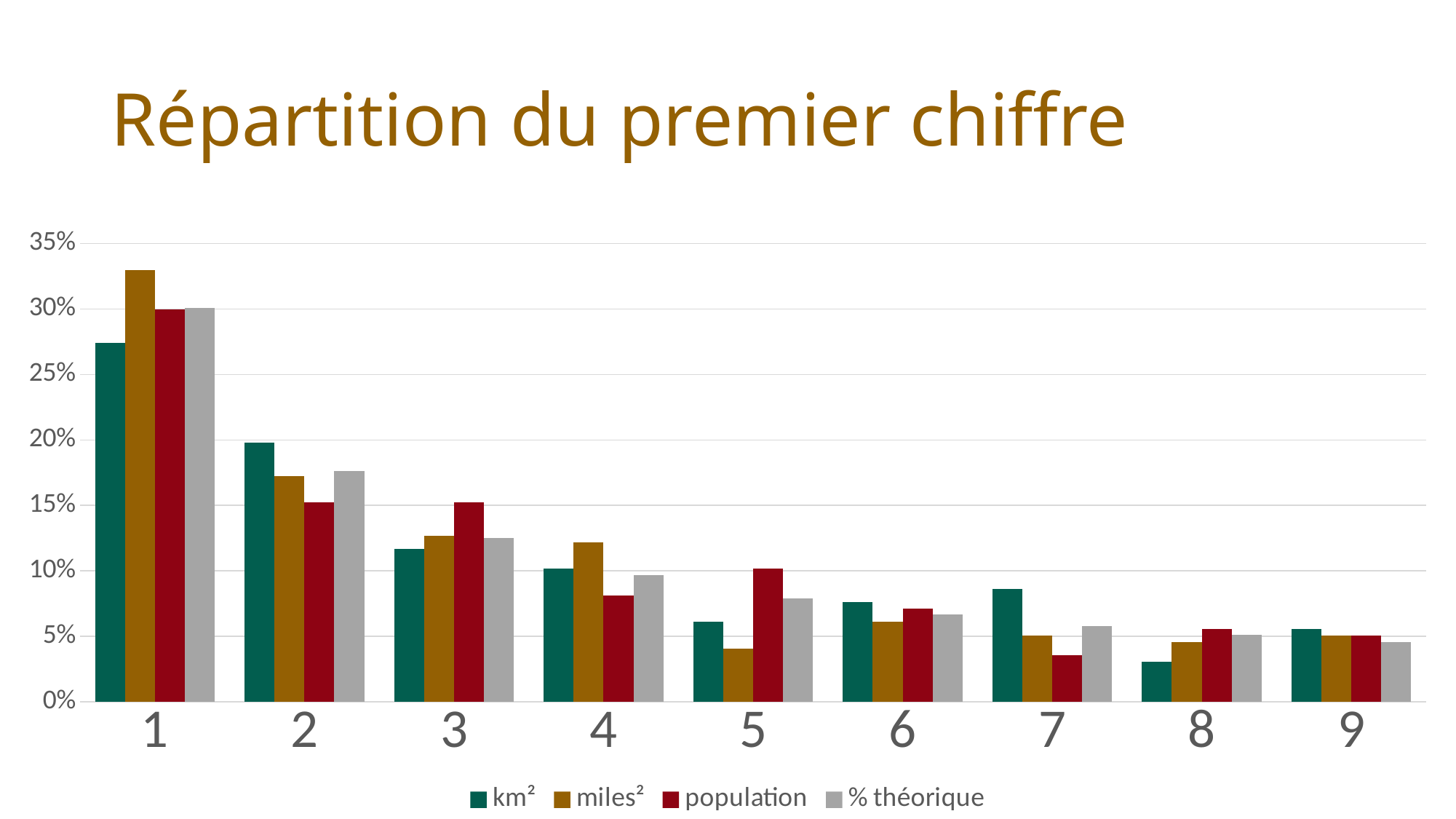
Is the km² value for category 1 greater or less than 25%? greater For category 5, which is larger: the population value or the miles² value? population What is the title of the chart? Répartition du premier chiffre Which category has the highest miles² value? 1 Do the km² values rise or fall from category 1 to category 4? fall For category 2, which is larger: the km² value or the population value? km² How many categories are shown on the x axis? 9 Is the miles² value for category 5 greater or less than 5%? less How many series does the legend list? 4 What kind of chart is shown on the slide? bar chart Is the population value for category 3 greater or less than 10%? greater Which category has the lowest km² value? 8